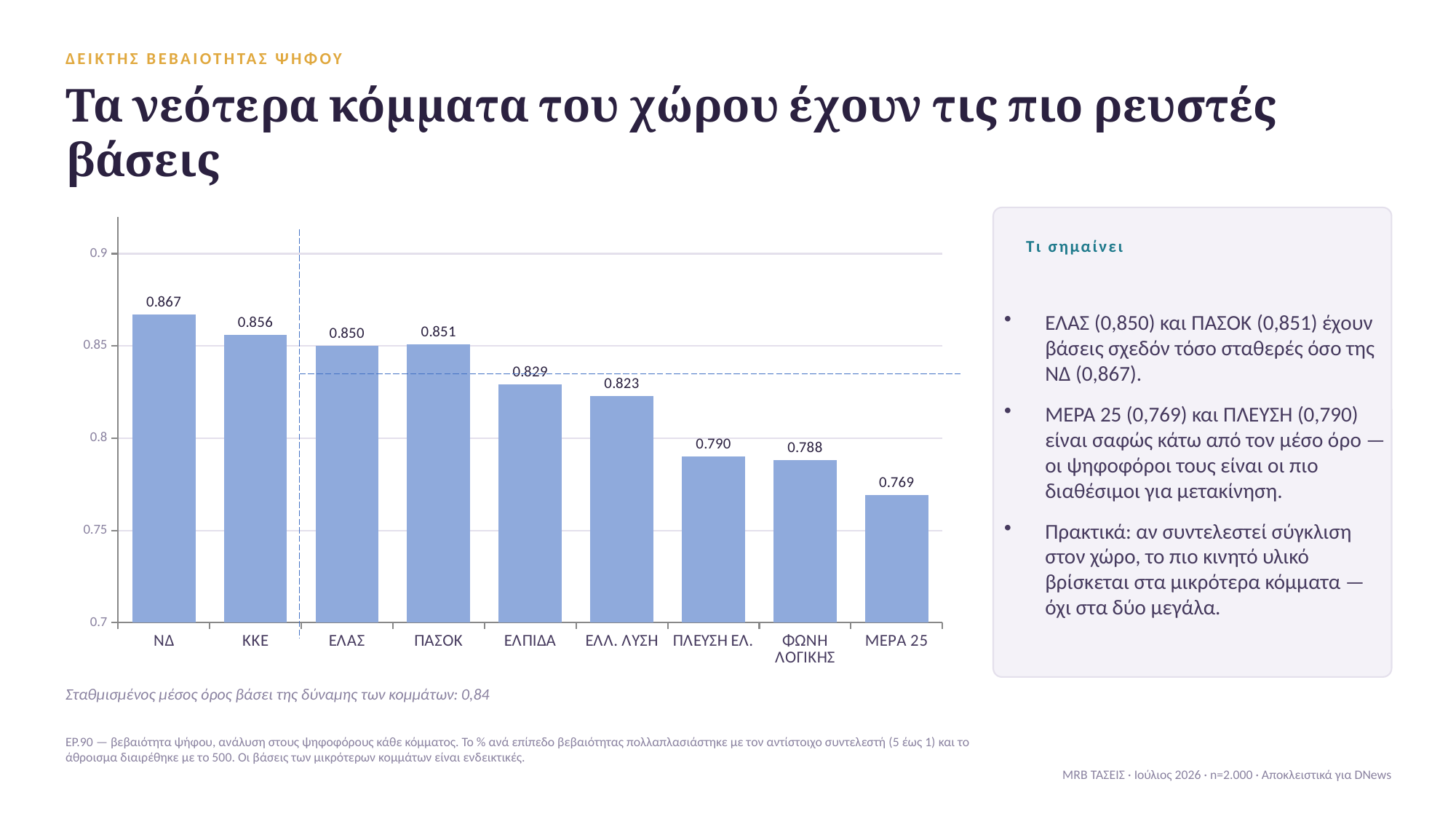
How many parties are shown in the chart? 9 What is the difference between the values for ΚΚΕ and ΕΛΠΙΔΑ? 0.027 Which has a higher value, ΠΑΣΟΚ or ΕΛΛ. ΛΥΣΗ? ΠΑΣΟΚ What is the vote certainty index value for ΝΔ? 0.867 Is the value for ΠΛΕΥΣΗ ΕΛ. greater or less than 0.8? less Which party has the highest value in the chart? ΝΔ What kind of chart is shown on the slide? bar chart What is the value shown for ΜΕΡΑ 25? 0.769 Do the values generally rise or fall from left to right across the chart? fall What is the difference between the values for ΝΔ and ΜΕΡΑ 25? 0.098 Which party has the lowest value in the chart? ΜΕΡΑ 25 What is the value shown for ΦΩΝΗ ΛΟΓΙΚΗΣ? 0.788